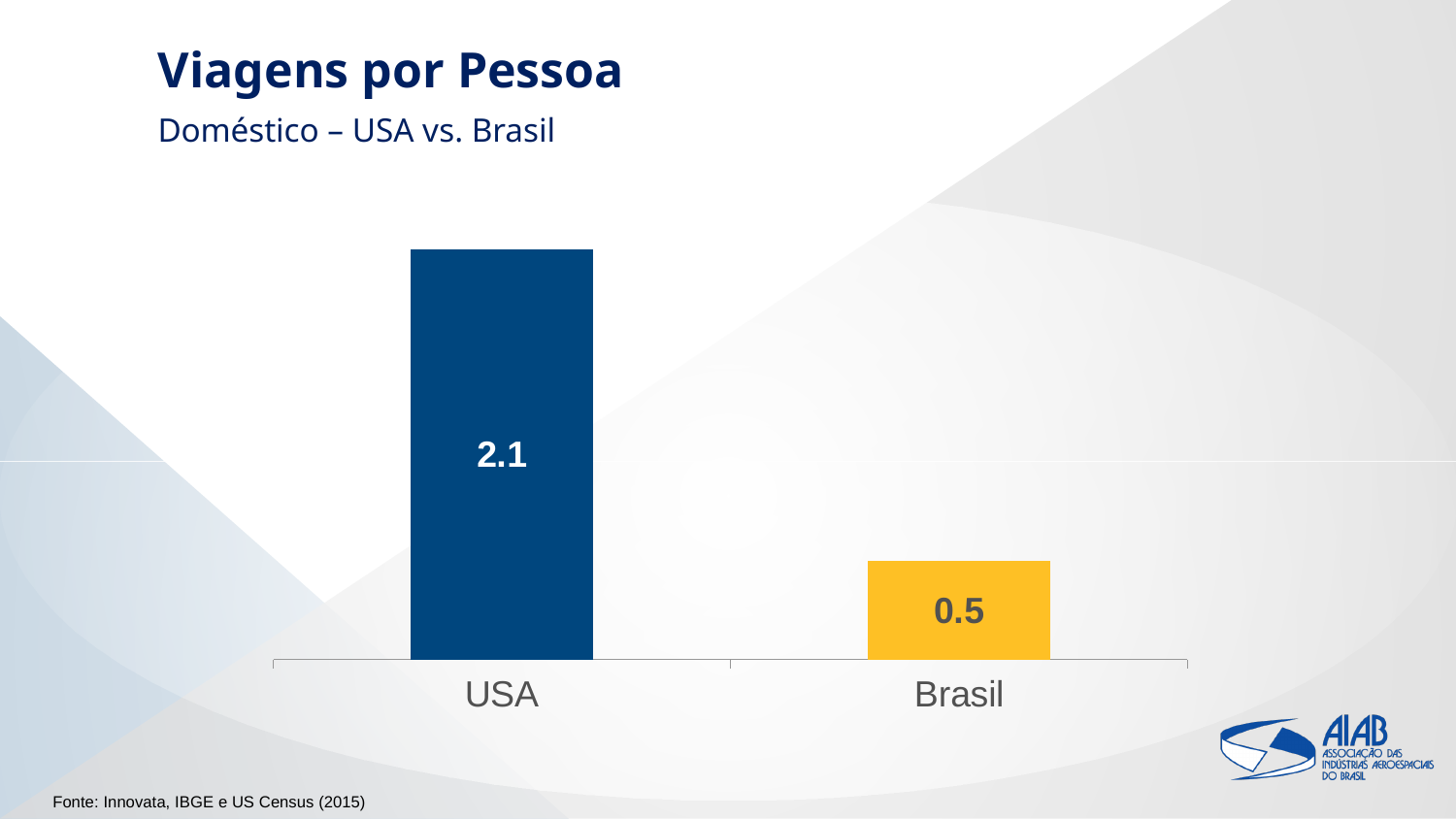
What colour is the bar for Brasil? Yellow What is the title of the slide? Viagens por Pessoa What is the difference between the values for USA and Brasil? 1.6 Which category has the highest value? USA What is the value for Brasil? 0.5 What is the value for USA? 2.1 Which category has the lowest value? Brasil What kind of chart is shown on the slide? Bar chart Which is larger, the value for USA or the value for Brasil? USA How many categories are shown in the chart? 2